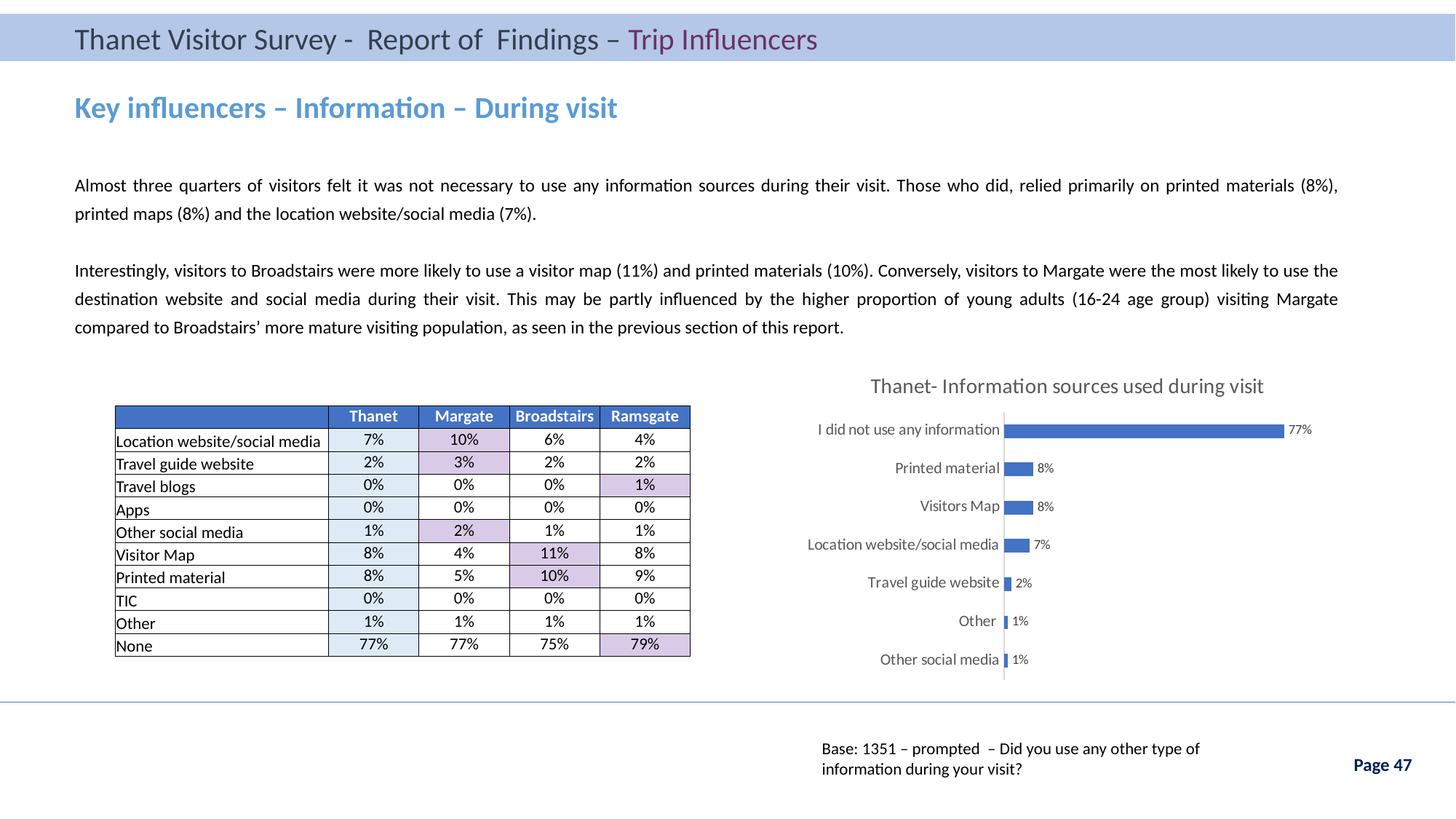
What is the difference between 'Visitors Map' and 'Travel guide website' in the chart? 6% What is the value for 'Other social media' in the chart? 1% What is the title of the chart? Thanet- Information sources used during visit What is the value for 'I did not use any information' in the chart? 77% Which category has the highest value in the chart? I did not use any information What is the value for 'Printed material' in the chart? 8% What is the difference between 'I did not use any information' and 'Printed material' in the chart? 69% What kind of chart is shown on the slide? Bar chart Which is larger in the chart, 'Location website/social media' or 'Travel guide website'? Location website/social media What is the value for 'Travel guide website' in the chart? 2% What is the value for 'Location website/social media' in the chart? 7% How many categories are shown in the chart? 7